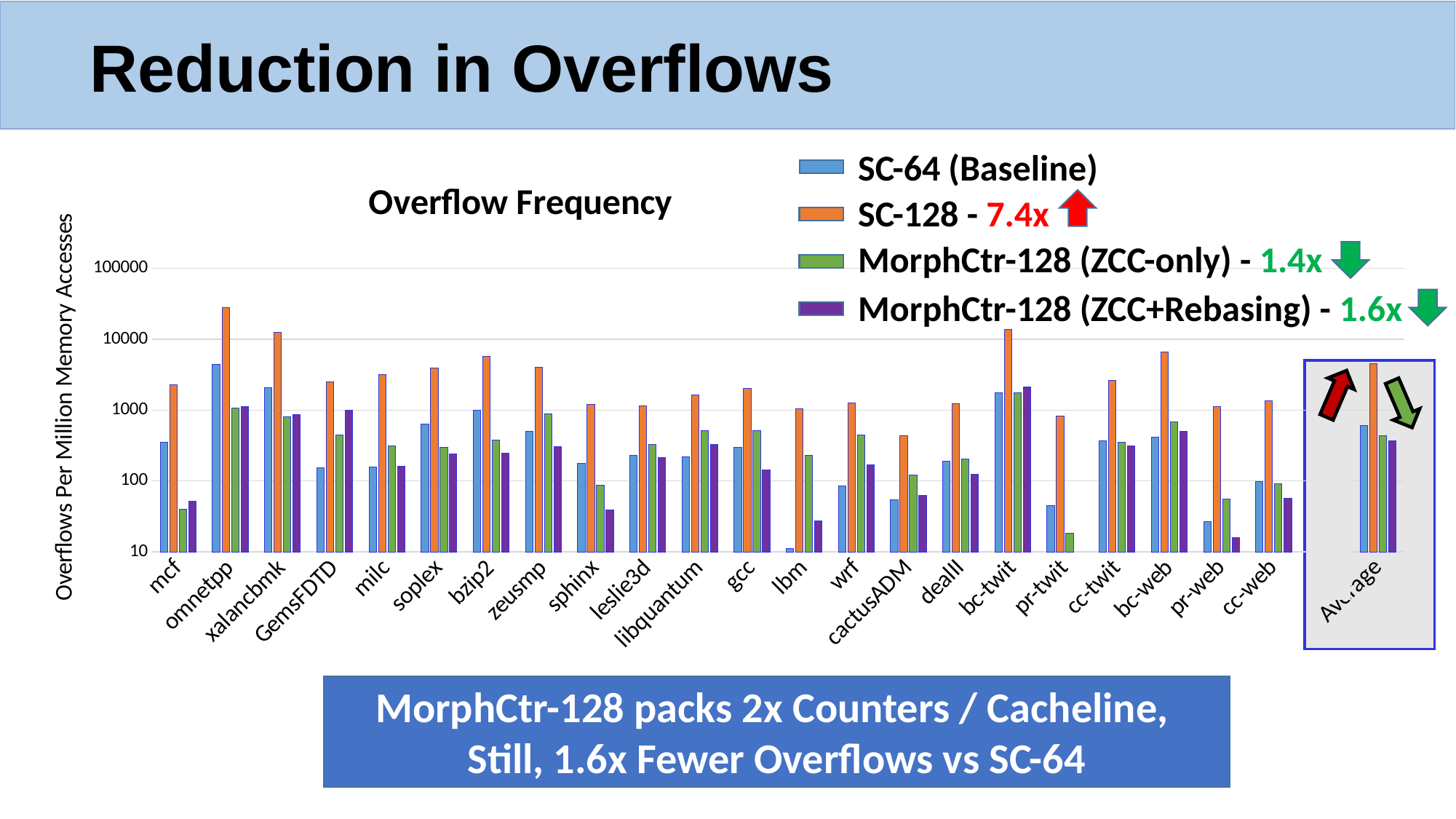
Is the SC-64 (Baseline) value for lbm greater or less than 100? less What is the title of the chart? Overflow Frequency Is the SC-128 value for omnetpp greater or less than 10000? greater Is the MorphCtr-128 (ZCC+Rebasing) value for pr-web greater or less than 100? less Which category has the lowest SC-64 (Baseline) bar? lbm For the Average category, which series has the tallest bar? SC-128 How many series does the chart legend list? 4 How many categories are shown along the x axis of the chart, including Average? 23 Which category has the highest SC-128 bar? omnetpp What is the label on the y axis of the chart? Overflows Per Million Memory Accesses What kind of chart is shown on the slide? bar chart